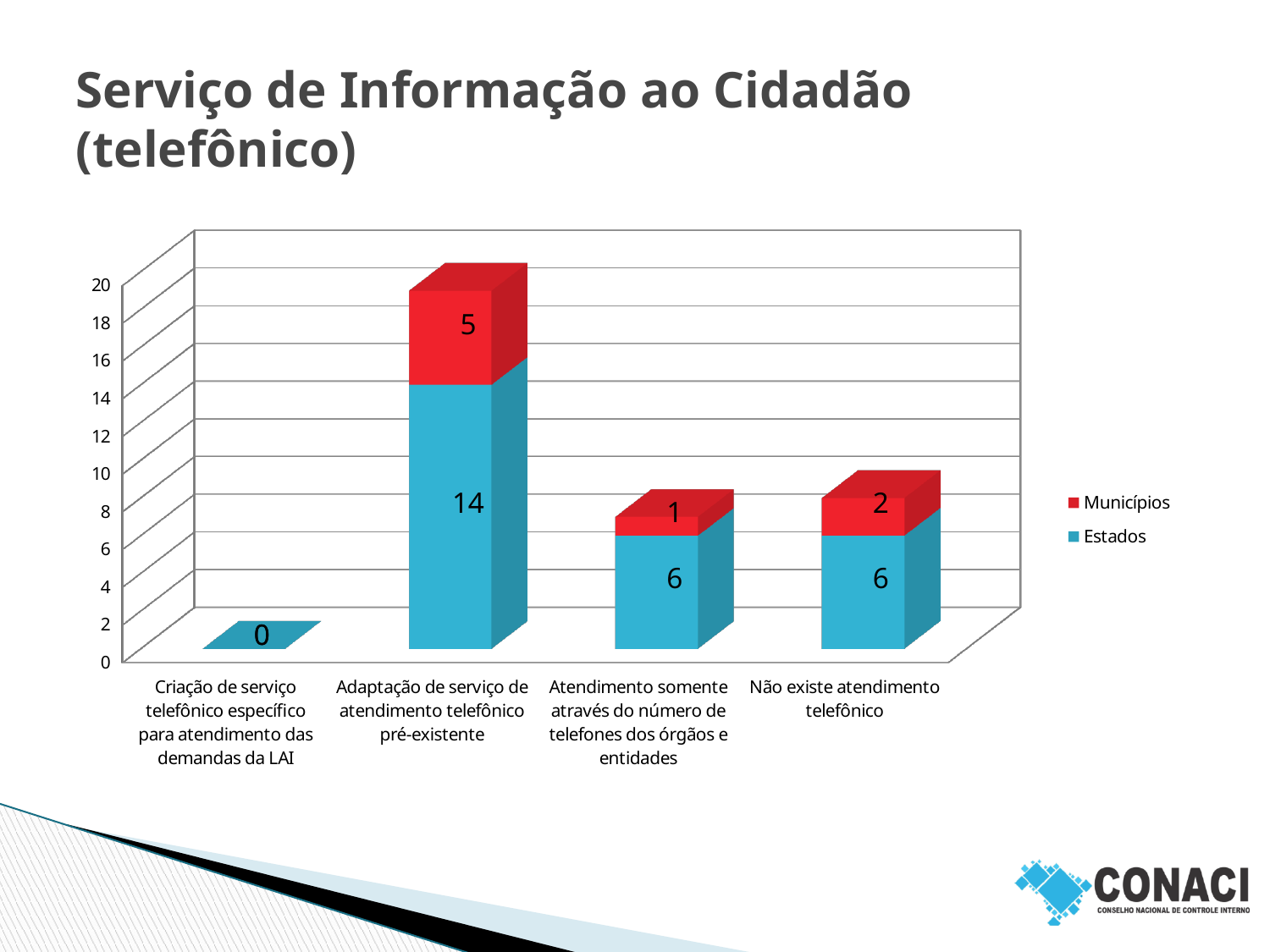
What is the difference between the Estados value and the Municípios value for 'Adaptação de serviço de atendimento telefônico pré-existente'? 9 What is the Estados value for 'Criação de serviço telefônico específico para atendimento das demandas da LAI'? 0 How many series does the legend list? 2 What is the Municípios value for 'Atendimento somente através do número de telefones dos órgãos e entidades'? 1 What is the total of the stacked bar for 'Não existe atendimento telefônico'? 8 Which is larger: the Municípios value for 'Não existe atendimento telefônico' or the Municípios value for 'Atendimento somente através do número de telefones dos órgãos e entidades'? Não existe atendimento telefônico Which category has the lowest Estados value? Criação de serviço telefônico específico para atendimento das demandas da LAI Which category has the highest Estados value? Adaptação de serviço de atendimento telefônico pré-existente What is the Municípios value for 'Não existe atendimento telefônico'? 2 What is the total of the stacked bar for 'Adaptação de serviço de atendimento telefônico pré-existente'? 19 What is the Estados value for 'Adaptação de serviço de atendimento telefônico pré-existente'? 14 How many categories are shown on the x axis? 4